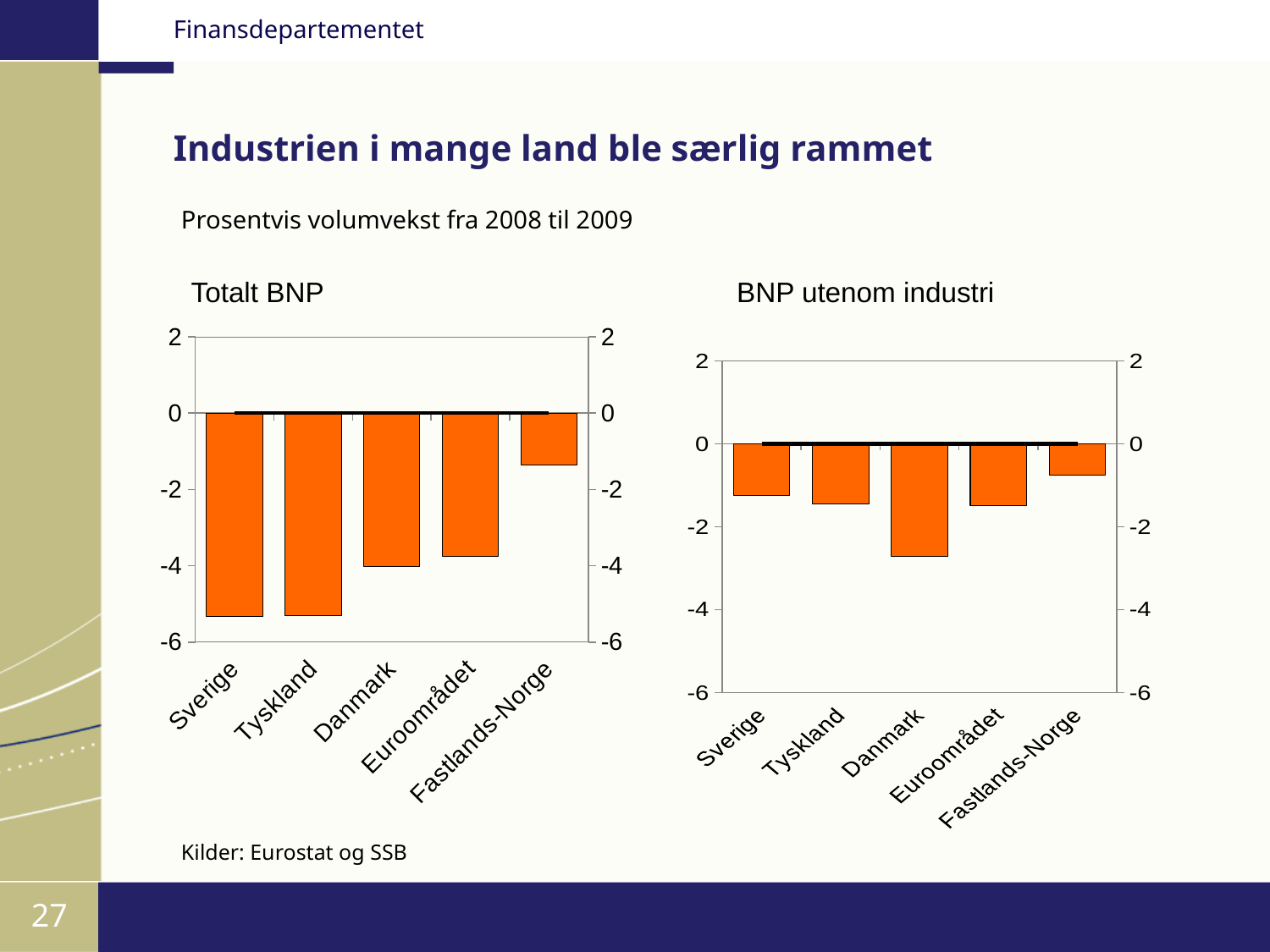
How many countries or regions are shown in the "Totalt BNP" chart? 5 In the "BNP utenom industri" chart, which category has the lowest value? Danmark In the "BNP utenom industri" chart, is the value for Danmark greater or less than -2? less In the "Totalt BNP" chart, which is larger, the value for Danmark or the value for Tyskland? Danmark What is the title of the chart on the right side of the slide? BNP utenom industri In the "Totalt BNP" chart, is the value for Fastlands-Norge greater or less than -2? greater In the "BNP utenom industri" chart, which category has the highest (least negative) value? Fastlands-Norge In the "BNP utenom industri" chart, is the value for Sverige greater or less than -2? greater In the "BNP utenom industri" chart, which is larger, the value for Fastlands-Norge or the value for Danmark? Fastlands-Norge What kind of chart is the "Totalt BNP" chart? bar chart In the "Totalt BNP" chart, which category has the highest (least negative) value? Fastlands-Norge